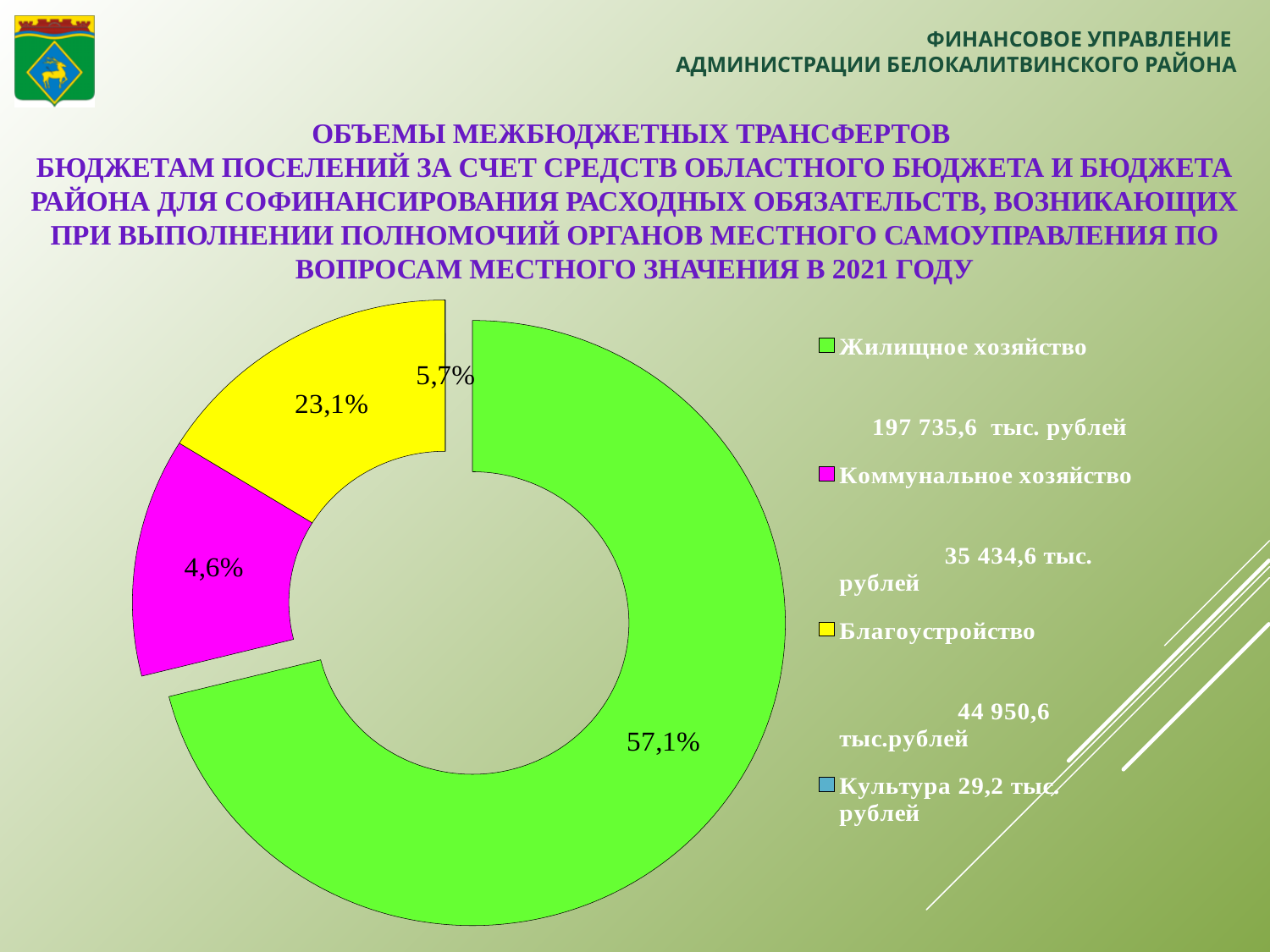
What amount in тыс. рублей is given for Благоустройство in the legend? 44 950,6 тыс. рублей What percentage share is shown for Коммунальное хозяйство? 4,6% Which has a larger share, Благоустройство or Коммунальное хозяйство? Благоустройство What percentage share is shown for Жилищное хозяйство? 57,1% Which category has the smallest amount in тыс. рублей according to the legend? Культура What amount in тыс. рублей is given for Жилищное хозяйство in the legend? 197 735,6 тыс. рублей What percentage share is shown for Благоустройство? 23,1% What kind of chart is shown on the slide? doughnut chart Which category has the largest share of the chart? Жилищное хозяйство What is the difference in percentage points between the shares of Благоустройство (23,1%) and Коммунальное хозяйство (4,6%)? 18,5% How many categories does the legend list? 4 What amount is given for Культура in the legend? 29,2 тыс. рублей